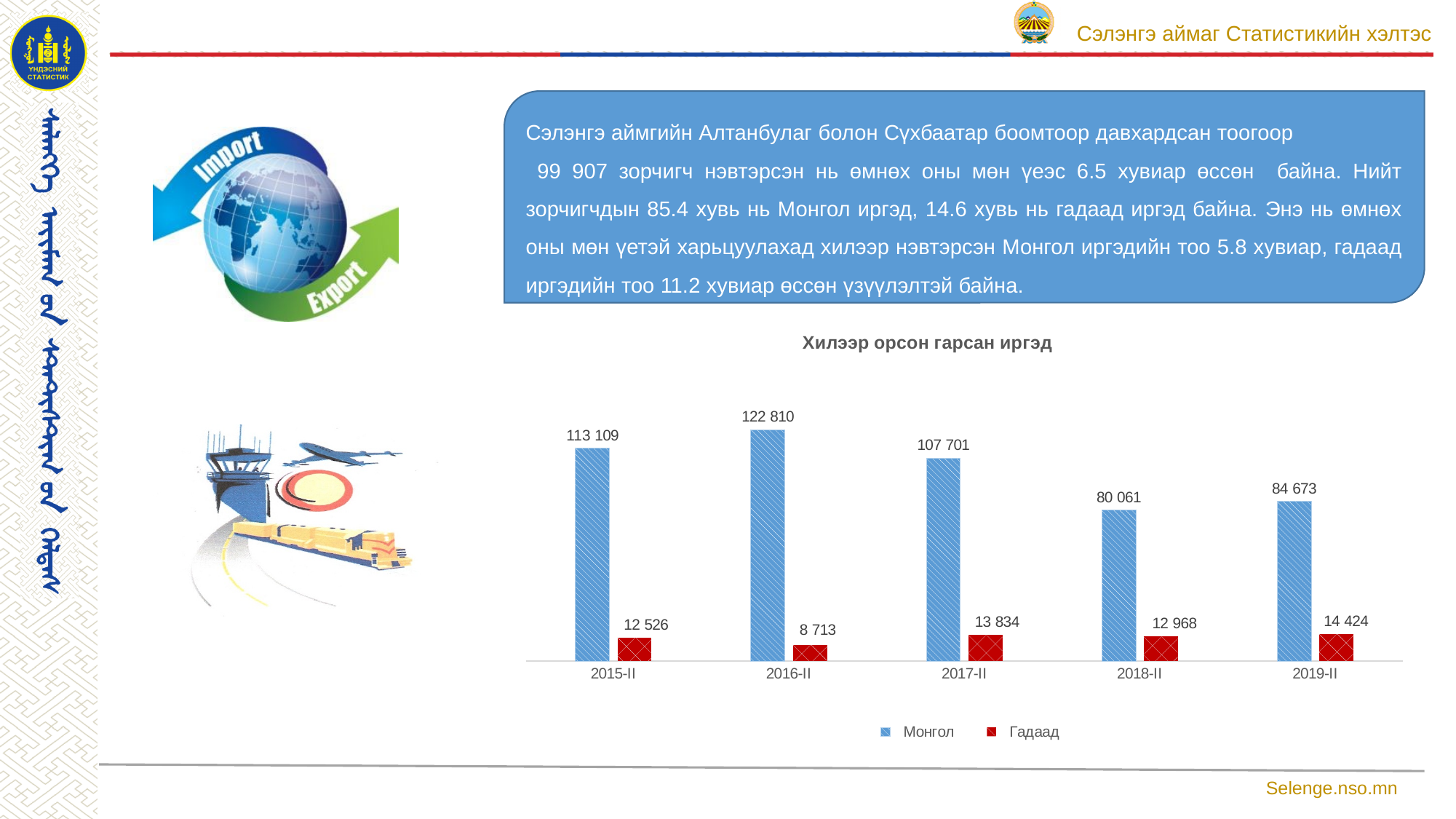
How many series does the legend of the chart list? 2 What is the value for Монгол in 2018-II? 80 061 What type of chart is shown under the title 'Хилээр орсон гарсан иргэд'? bar chart Which is larger: the Монгол value in 2015-II or in 2017-II? 2015-II How many periods are shown on the x axis of the chart? 5 What is the difference between the Гадаад values in 2017-II and 2016-II? 5 121 By how much did the Монгол value change from 2018-II to 2019-II? 4 612 What is the value for Гадаад in 2019-II? 14 424 Which series is shown in red in the chart? Гадаад What is the value for Монгол in 2016-II? 122 810 In which period is the Монгол value highest? 2016-II In which period is the Гадаад value lowest? 2016-II